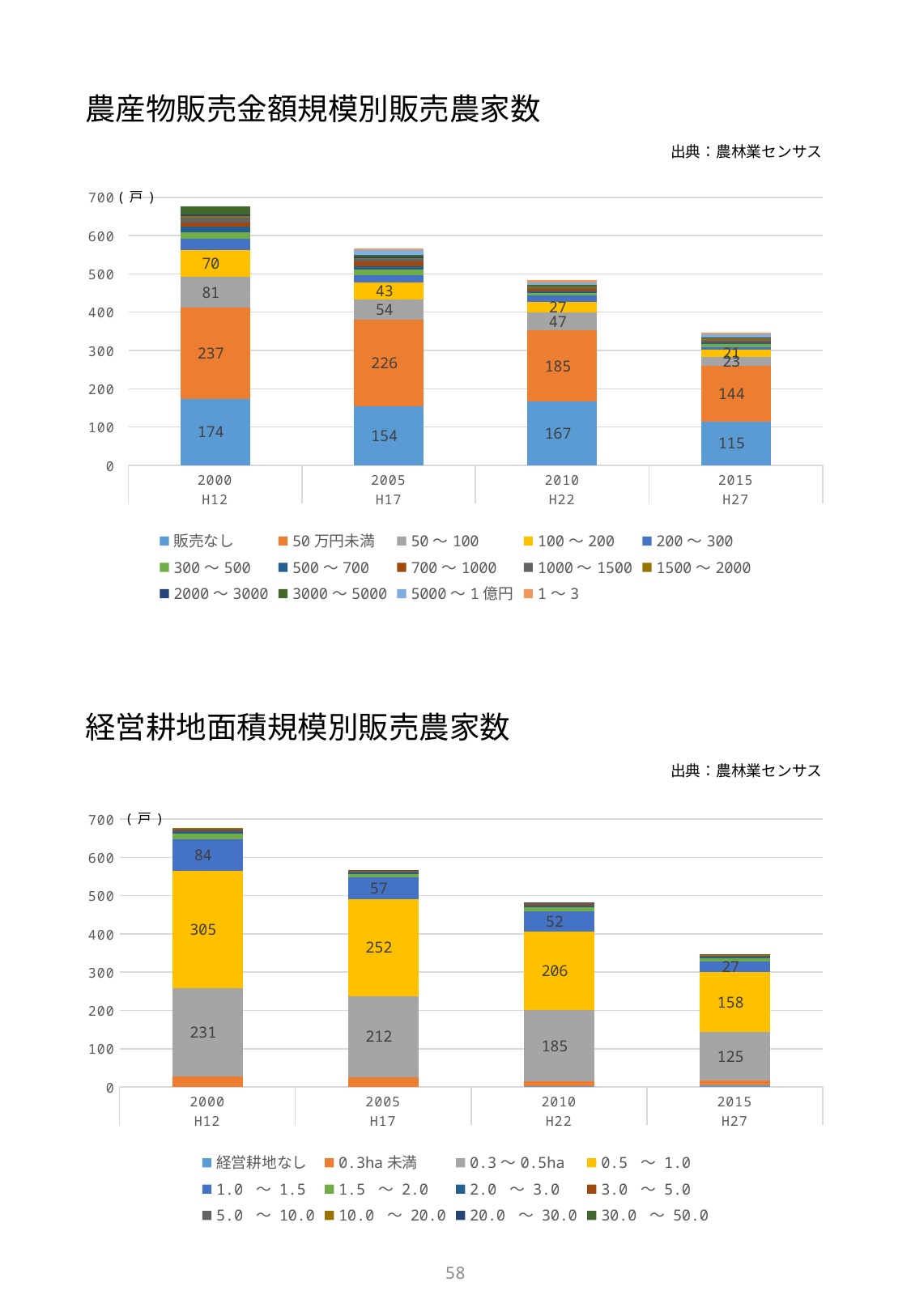
In the top chart (農産物販売金額規模別販売農家数), what is the value for 販売なし in 2000 (H12)? 174 In the top chart (農産物販売金額規模別販売農家数), how many series does the legend list? 14 In the top chart (農産物販売金額規模別販売農家数), is the total stacked bar for 2015 (H27) greater or less than 400? less In the top chart (農産物販売金額規模別販売農家数), what is the value for 50万円未満 in 2015 (H27)? 144 In the bottom chart (経営耕地面積規模別販売農家数), what is the difference between the 0.5〜1.0 values for 2000 (H12) and 2015 (H27)? 147 What kind of chart is the bottom chart (経営耕地面積規模別販売農家数)? Stacked bar chart In the bottom chart (経営耕地面積規模別販売農家数), how many years are shown on the x axis? 4 In the bottom chart (経営耕地面積規模別販売農家数), what is the value for 0.5〜1.0 in 2010 (H22)? 206 In the bottom chart (経営耕地面積規模別販売農家数), which year has the lowest value for 1.0〜1.5? 2015 (H27) In the bottom chart (経営耕地面積規模別販売農家数), which is larger: the 0.3〜0.5ha value in 2005 (H17) or the 0.5〜1.0 value in 2005 (H17)? 0.5〜1.0 (252) In the top chart (農産物販売金額規模別販売農家数), what is the difference between the 50万円未満 values for 2000 (H12) and 2005 (H17)? 11 In the top chart (農産物販売金額規模別販売農家数), which year has the highest value for 50〜100? 2000 (H12)